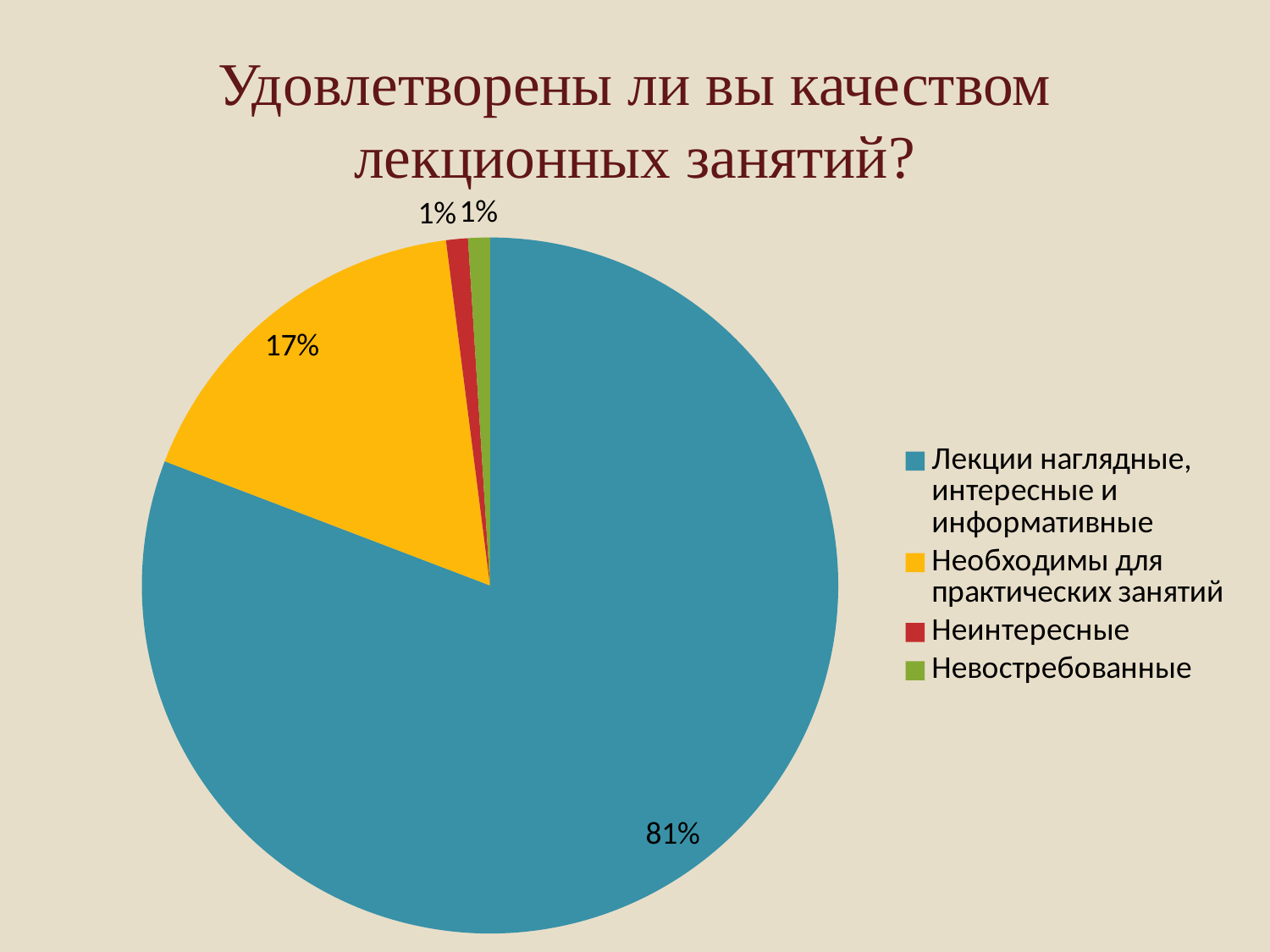
What share of the pie is labelled "Лекции наглядные, интересные и информативные"? 81% What share of the pie is labelled "Неинтересные"? 1% Which category has the largest slice of the pie? Лекции наглядные, интересные и информативные What is the difference between the shares for "Лекции наглядные, интересные и информативные" and "Необходимы для практических занятий"? 64% What share of the pie is labelled "Необходимы для практических занятий"? 17% What is the title of the slide? Удовлетворены ли вы качеством лекционных занятий? What is the combined share of "Неинтересные" and "Невостребованные"? 2% Which is larger: the share for "Необходимы для практических занятий" or the share for "Неинтересные"? Необходимы для практических занятий What kind of chart is shown on the slide? pie chart What colour is the slice for "Необходимы для практических занятий"? yellow What share of the pie is labelled "Невостребованные"? 1% How many categories does the legend list? 4